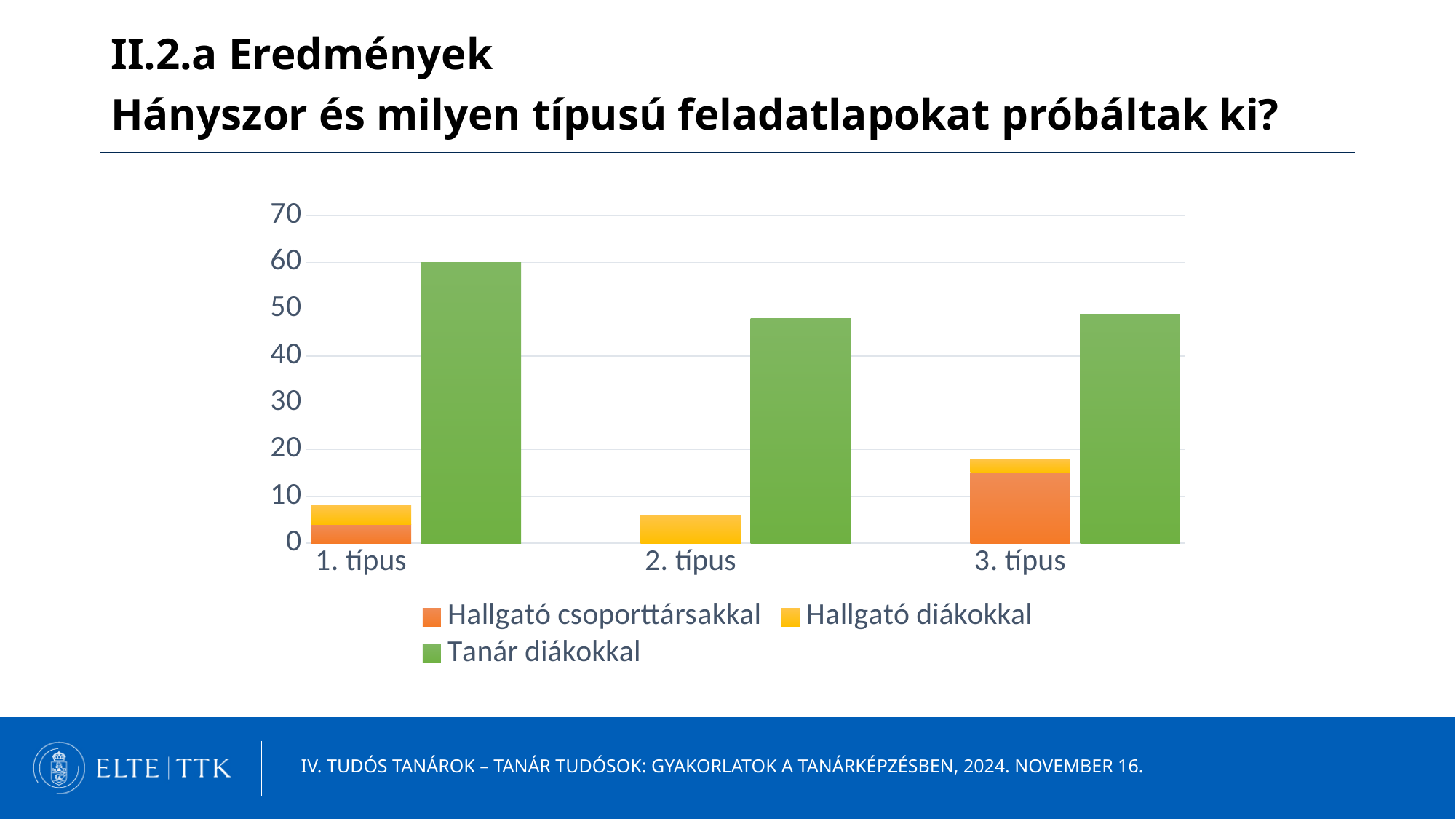
Is the total of the stacked Hallgató bar for 1. típus greater or less than 10? less What is the value of Tanár diákokkal for 1. típus? 60 Is the value of Tanár diákokkal for 3. típus greater or less than 40? greater Which is larger: Tanár diákokkal for 1. típus or for 2. típus? 1. típus Which category has the highest value for Tanár diákokkal? 1. típus Is the total of the stacked Hallgató bar for 3. típus greater or less than 20? less Which category has the highest value for Hallgató csoporttársakkal? 3. típus How many categories are shown on the x axis? 3 How many series does the legend list? 3 What kind of chart is shown on the slide? bar chart What colour represents Tanár diákokkal in the legend? green